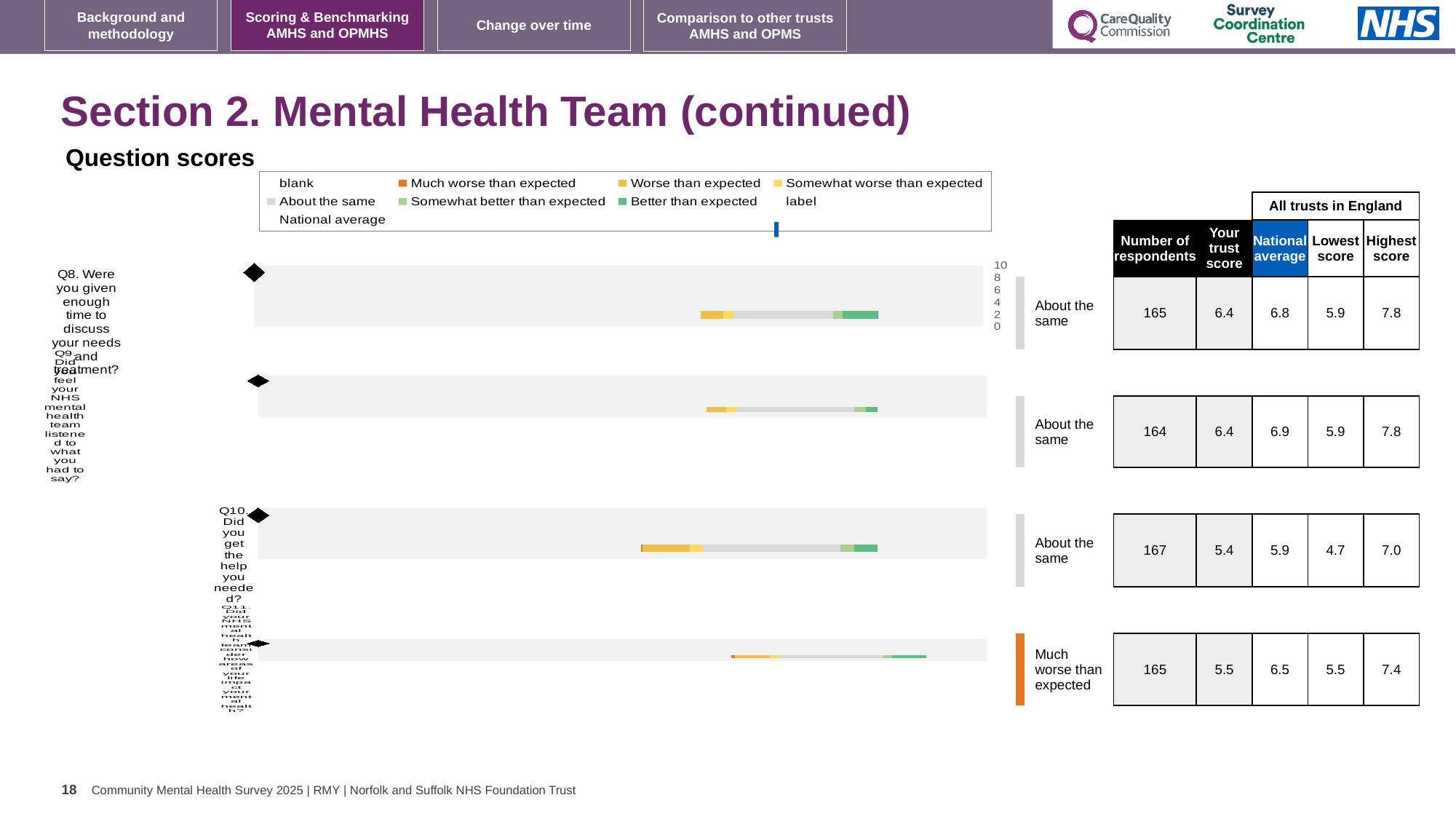
What benchmark category label is shown next to the Q11 chart? Much worse than expected What kind of chart is used to show the Q8 question score? bar chart For the Q9 chart, what is the highest score among all trusts in England? 7.8 For the Q10 chart, what is the national average shown in the table? 5.9 For the Q11 chart, how many respondents are shown in the table? 165 In the chart legend, which category is shown in orange? Much worse than expected How many question charts (Q8 to Q11) are shown on the slide? 4 For the Q8 chart, what is the trust's score shown in the table? 6.4 Which question (Q8 to Q11) has the lowest trust score in the table? Q10 For the Q11 chart, which is larger: the trust's score or the national average? National average For the Q10 chart, what is the difference between the highest score (7.0) and the lowest score (4.7)? 2.3 In the chart legend, which category is shown in dark green? Better than expected